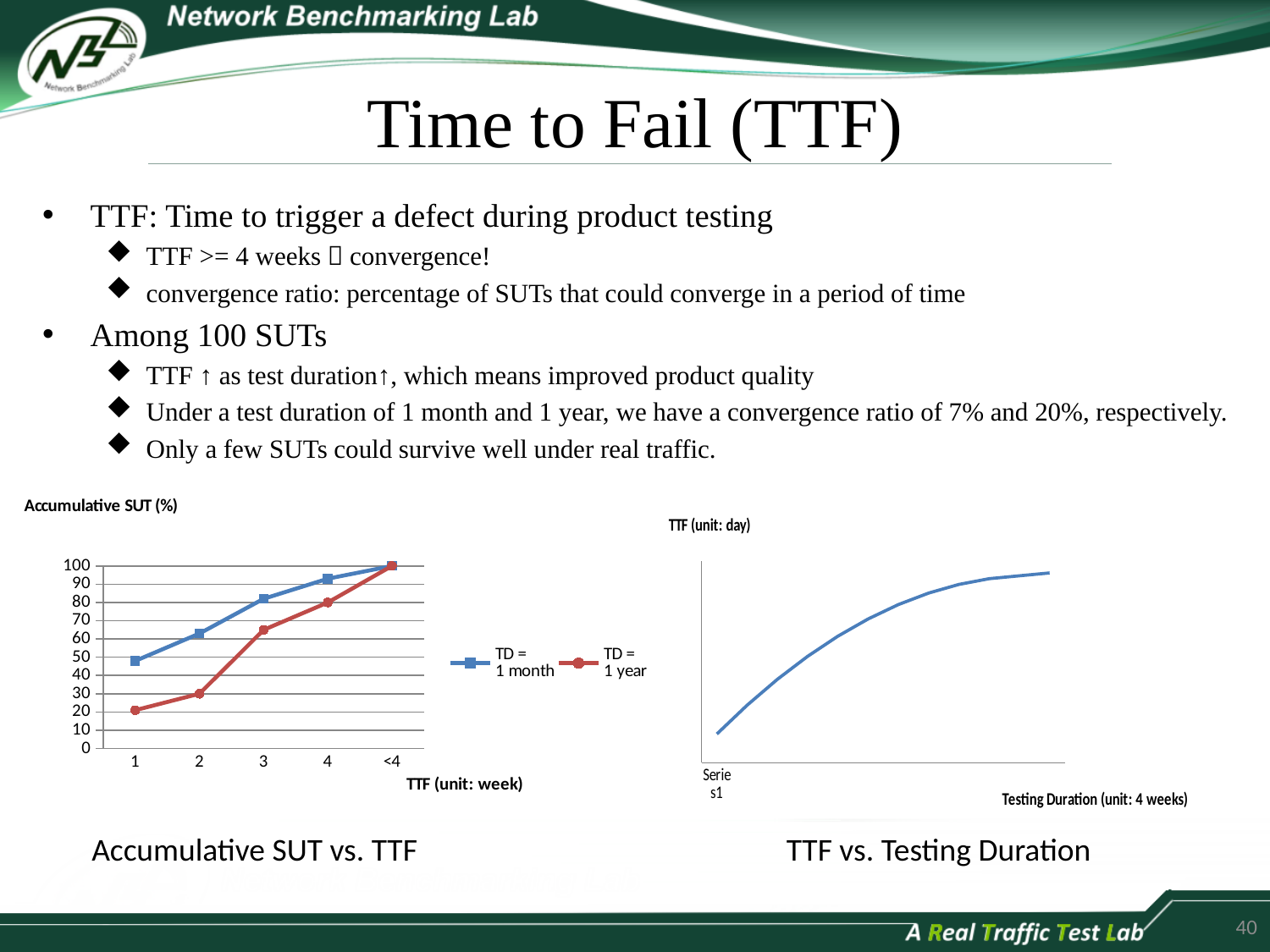
In the 'Accumulative SUT vs. TTF' chart, what kind of chart is it? line chart In the 'Accumulative SUT vs. TTF' chart, how many categories are on the x axis? 5 In the 'TTF vs. Testing Duration' chart, does the line rise or fall from left to right? rise In the 'TTF vs. Testing Duration' chart, what is the x-axis title? Testing Duration (unit: 4 weeks) In the 'Accumulative SUT vs. TTF' chart, is the value for TD = 1 month at TTF 4 greater or less than 80? greater In the 'Accumulative SUT vs. TTF' chart, which series has the larger value at TTF 1, TD = 1 month or TD = 1 year? TD = 1 month In the 'Accumulative SUT vs. TTF' chart, is the value for TD = 1 year at TTF 3 greater or less than 50? greater In the 'Accumulative SUT vs. TTF' chart, is the value for TD = 1 year at TTF 1 greater or less than 30? less In the 'Accumulative SUT vs. TTF' chart, how many series does the legend list? 2 In the 'Accumulative SUT vs. TTF' chart, what is the x-axis title? TTF (unit: week) In the 'Accumulative SUT vs. TTF' chart, do the values for TD = 1 year rise or fall as TTF increases? rise